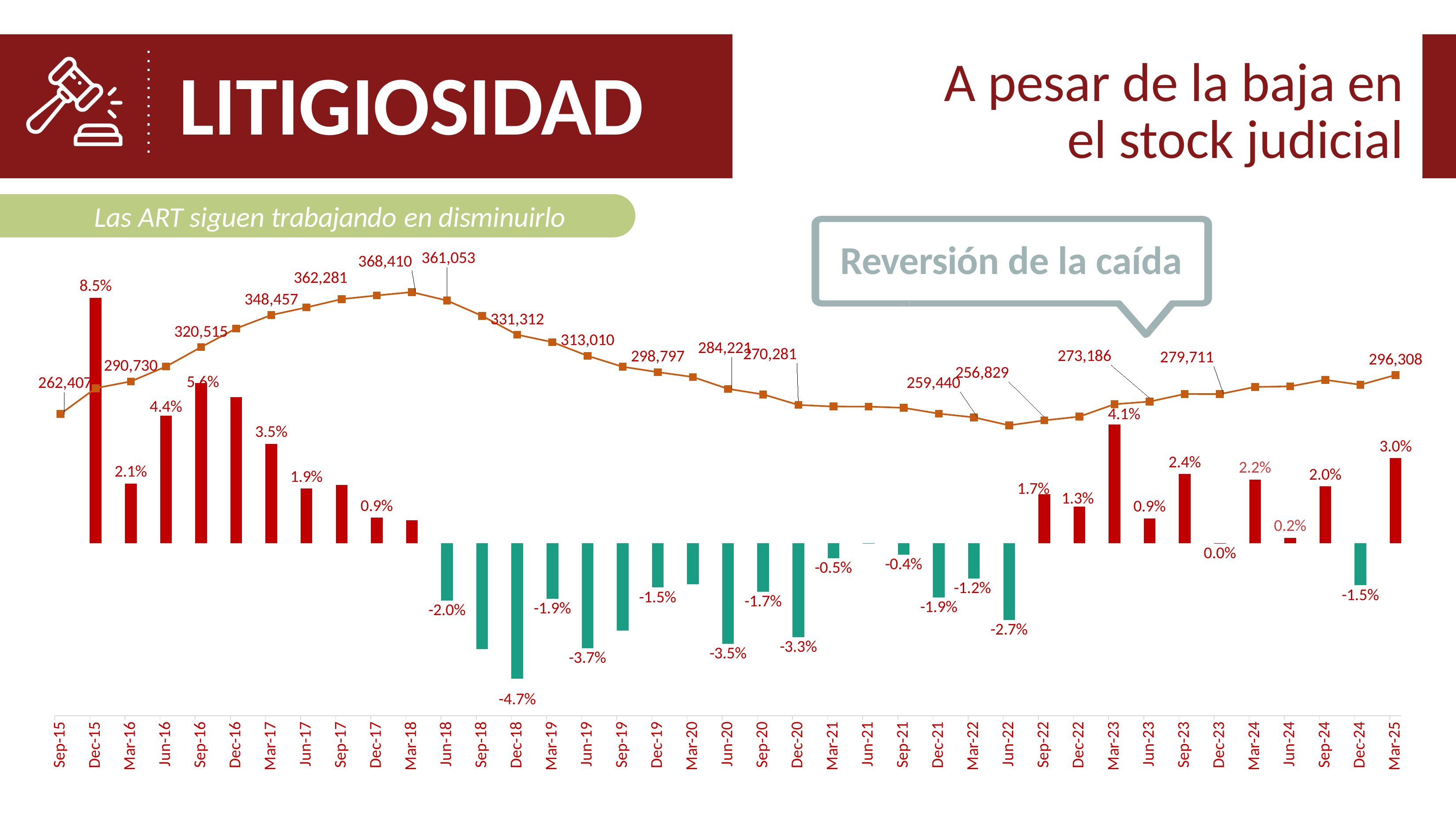
What kind of chart is shown on the slide? Combined bar and line chart What is the highest value labelled on the line? 368,410 What is the percentage value of the bar for Dec-18? -4.7% Which bar is larger, Jun-16 or Sep-16? Sep-16 What is the percentage value of the bar for Dec-15? 8.5% Which quarter has the highest bar (largest percentage change)? Dec-15 What is the percentage value of the bar for Mar-23? 4.1% What is the value of the line at Sep-15, the first point? 262,407 Which quarter has the lowest bar (most negative percentage change)? Dec-18 What is the difference between the peak line value of 368,410 and the first value of 262,407? 106,003 What is the percentage value of the bar for Mar-25? 3.0% What is the value of the line at Mar-25, the last point? 296,308